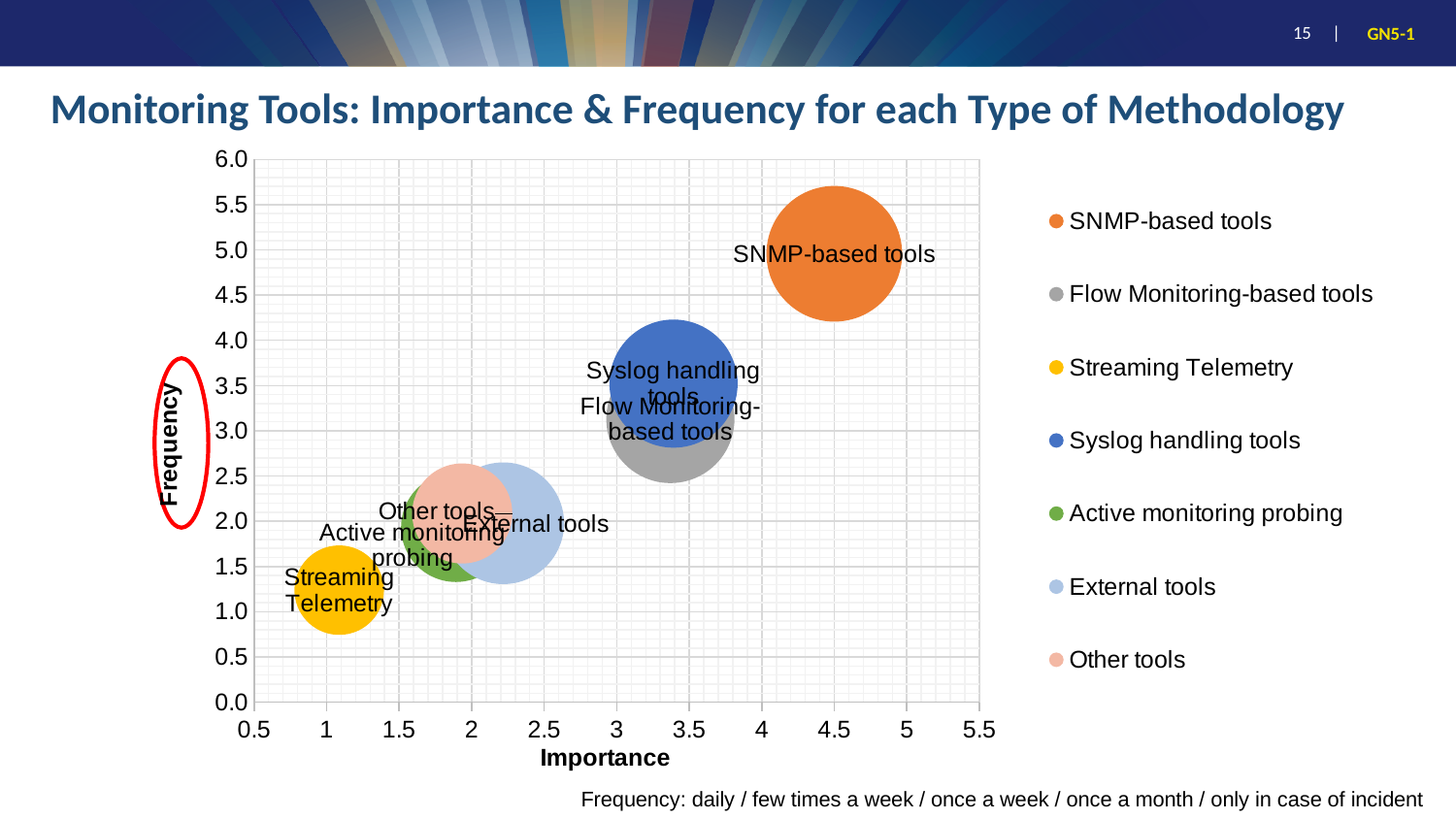
How many bubbles (monitoring tool types) are plotted on the chart? 7 How many series does the legend list? 7 Is the frequency value for Streaming Telemetry greater or less than 1.5? less Is the frequency value for SNMP-based tools greater or less than 4.5? greater Is the importance value for Flow Monitoring-based tools greater or less than 3? greater Which monitoring tool type has the lowest importance? Streaming Telemetry What colour represents SNMP-based tools in the legend? Orange What kind of chart is shown on the slide? Bubble chart Which monitoring tool type has the lowest frequency? Streaming Telemetry Which has a higher frequency, Syslog handling tools or Flow Monitoring-based tools? Syslog handling tools Which monitoring tool type has the highest frequency? SNMP-based tools What is the label of the x axis? Importance